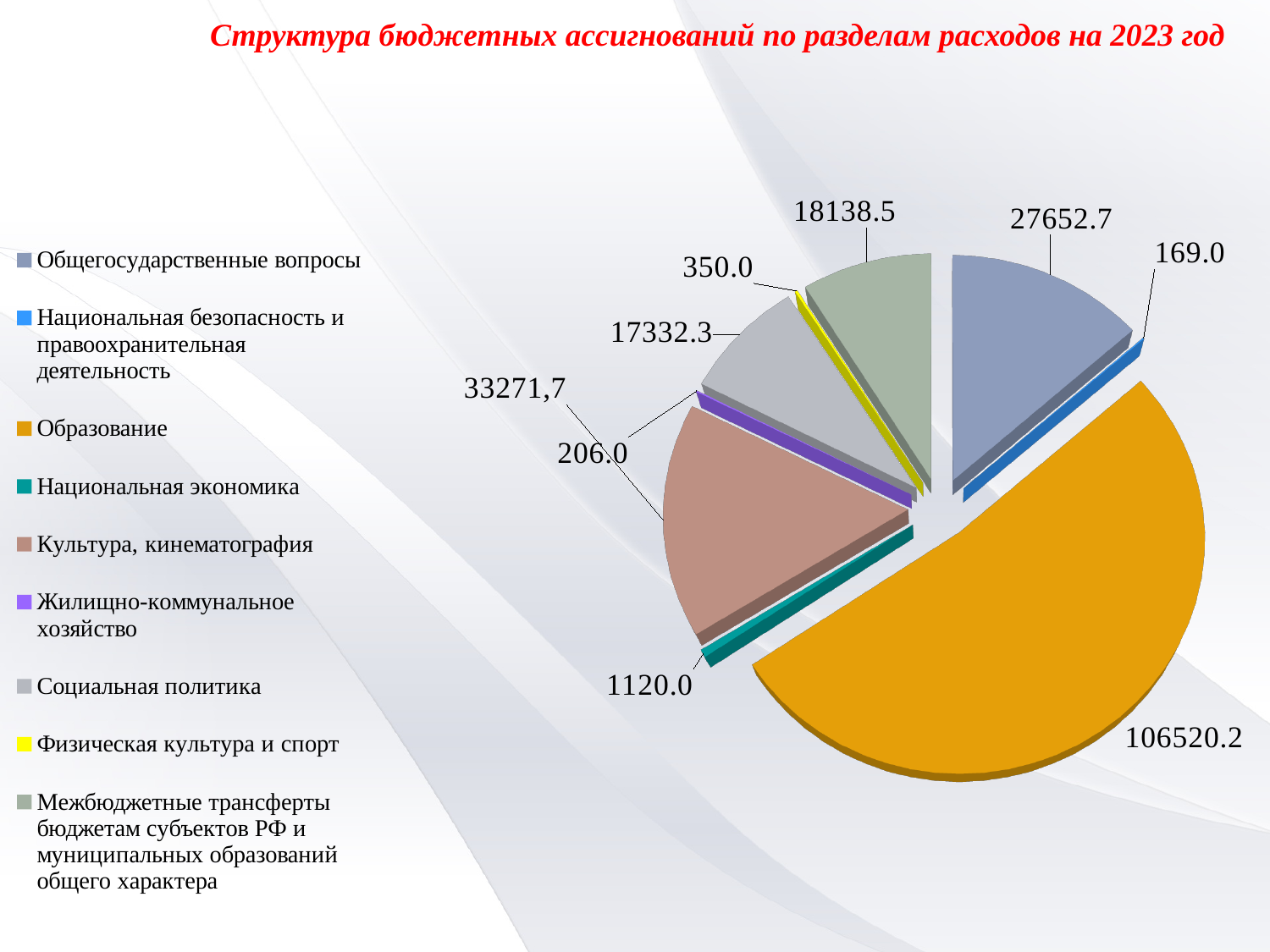
What is the value for Социальная политика? 17332.3 What is the value for Общегосударственные вопросы? 27652.7 What is the value for Национальная безопасность и правоохранительная деятельность? 169.0 What kind of chart is shown on the slide? pie chart What is the difference between the values for Общегосударственные вопросы and Межбюджетные трансферты бюджетам субъектов РФ и муниципальных образований общего характера? 9514.2 Which is larger, the value for Национальная экономика or the value for Физическая культура и спорт? Национальная экономика What is the value for Культура, кинематография? 33271,7 Which category has the largest slice of the pie? Образование Which category has the smallest slice of the pie? Национальная безопасность и правоохранительная деятельность What is the title of the chart? Структура бюджетных ассигнований по разделам расходов на 2023 год What is the value for Образование? 106520.2 How many categories does the legend list? 9